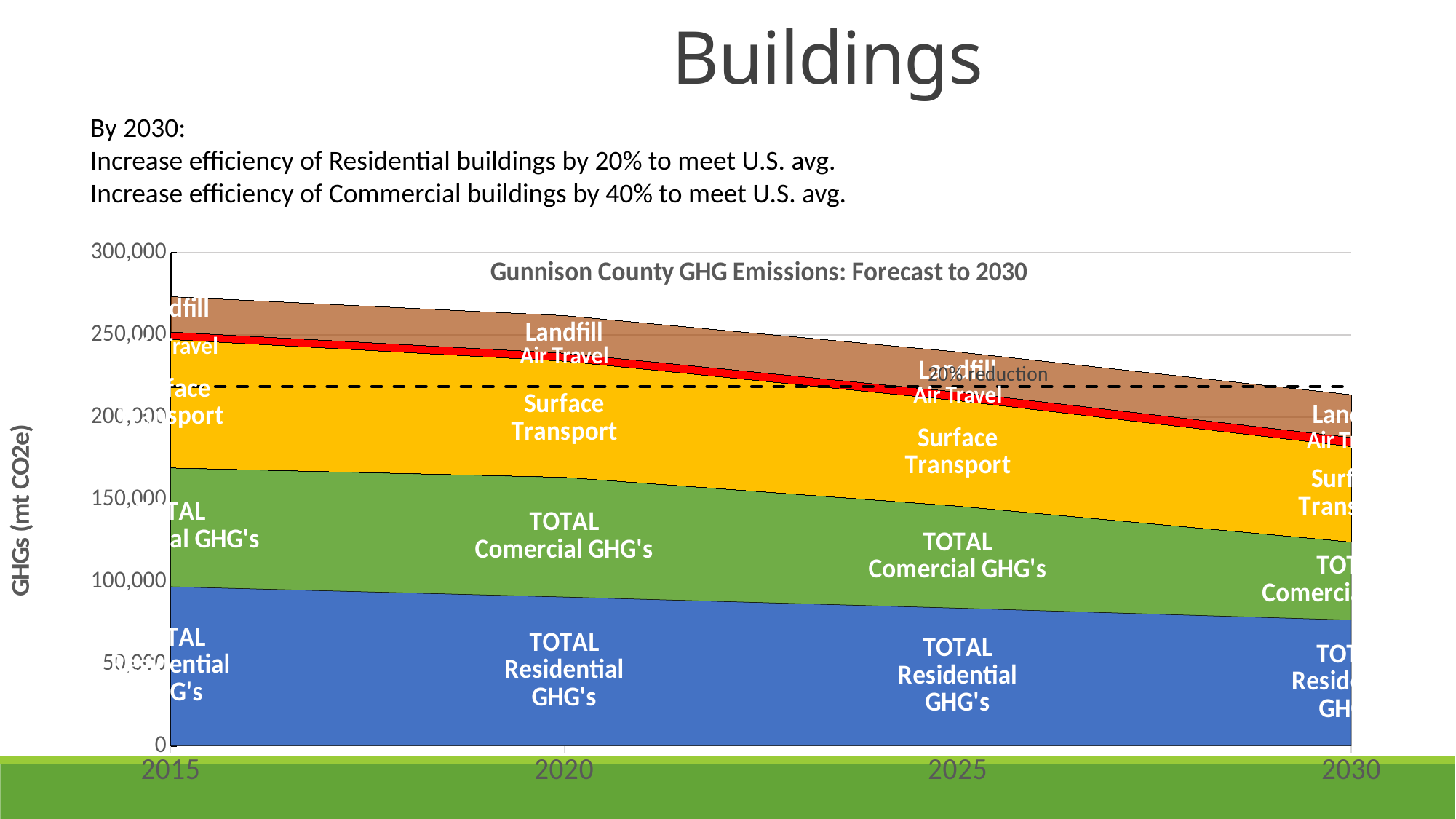
Which category occupies the largest band in the chart in 2015? TOTAL Residential GHG's Is the total stacked value in 2030 greater or less than 250,000? less Which category occupies the thinnest band in the chart? Air Travel Do total GHG emissions rise or fall from 2015 to 2030 in the chart? Fall Is the value for TOTAL Residential GHG's in 2015 greater or less than 100,000? less Is the TOTAL Residential GHG's band larger or smaller than the Surface Transport band in 2015? Larger How many years are marked on the x axis of the chart? 4 How many emission categories are stacked in the chart? 5 What type of chart is shown on the slide? Stacked area chart Is the total stacked value in 2015 greater or less than 250,000? greater What is the title of the chart? Gunnison County GHG Emissions: Forecast to 2030 What does the dashed horizontal line in the chart represent? 20% reduction